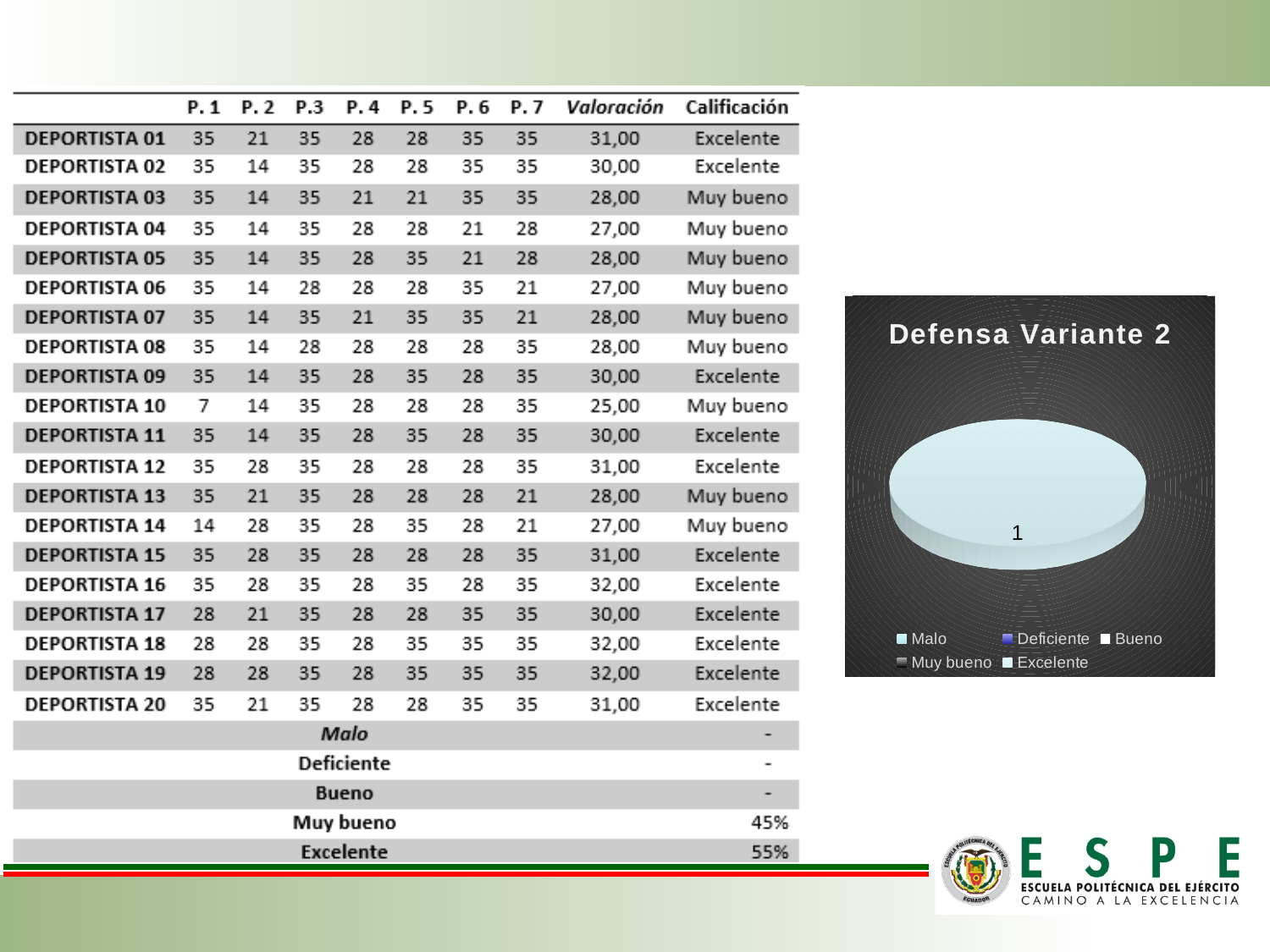
What kind of chart is shown on the right side of the slide? pie chart How many entries does the legend of the "Defensa Variante 2" pie chart list? 5 How many slices are visible in the "Defensa Variante 2" pie chart? 1 Which entries are listed in the legend of the "Defensa Variante 2" pie chart? Malo, Deficiente, Bueno, Muy bueno, Excelente What is the title of the pie chart? Defensa Variante 2 What data label is printed on the slice of the "Defensa Variante 2" pie chart? 1